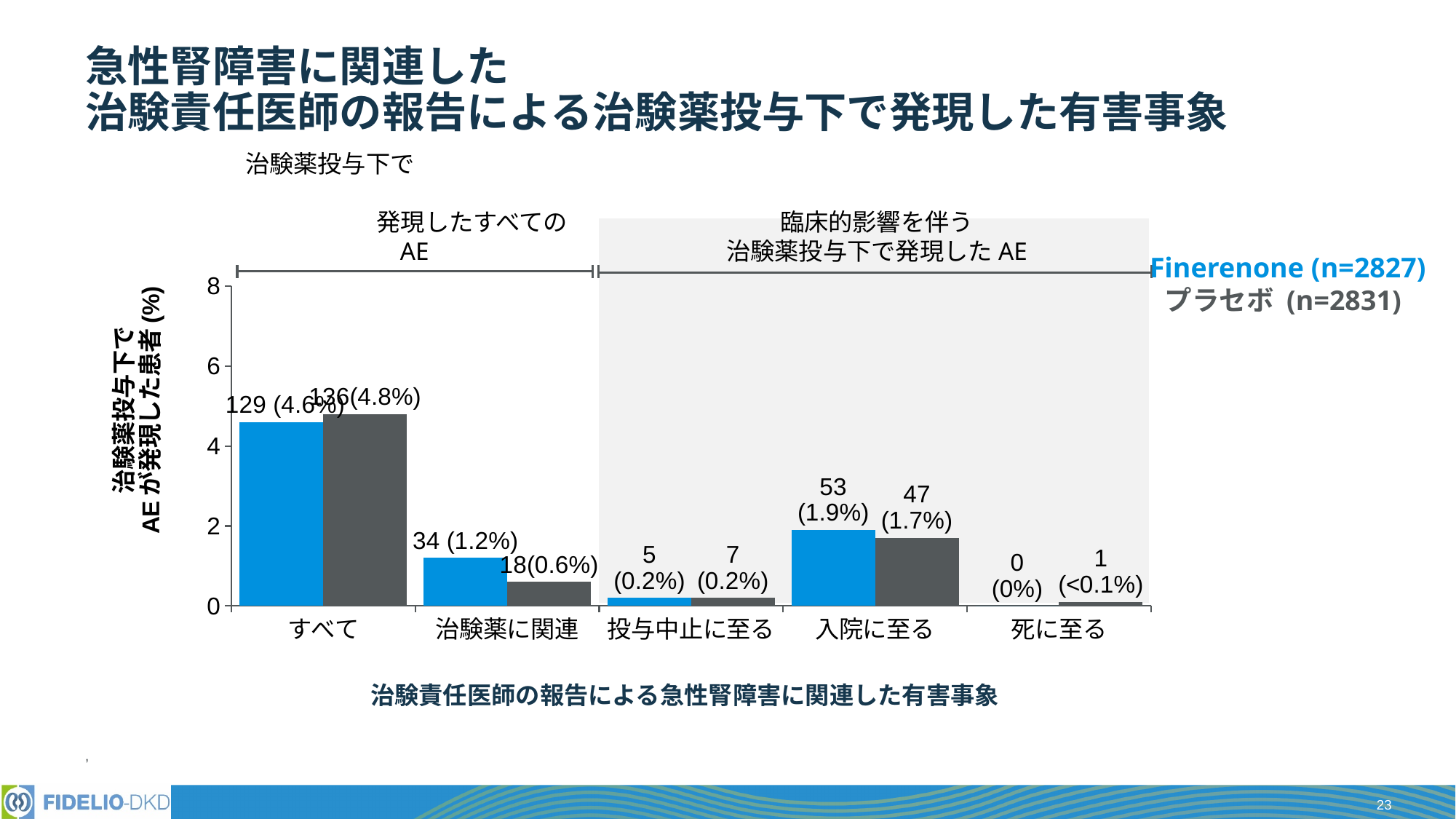
In the 治験薬に関連 category, which is larger, Finerenone or プラセボ? Finerenone What is the value for Finerenone in the 治験薬に関連 category? 34 (1.2%) How many categories are shown on the x axis of the chart? 5 Which category has the highest value for Finerenone? すべて What is the difference in patient count between Finerenone and プラセボ in the 入院に至る category? 6 What is the value for Finerenone in the すべて category? 129 (4.6%) How many series does the chart's legend list? 2 What is the value for プラセボ in the 入院に至る category? 47 (1.7%) Which category has the lowest value for プラセボ? 死に至る What is the value for プラセボ in the すべて category? 136 (4.8%) What is the value for Finerenone in the 死に至る category? 0 (0%) What kind of chart is shown on the slide? bar chart